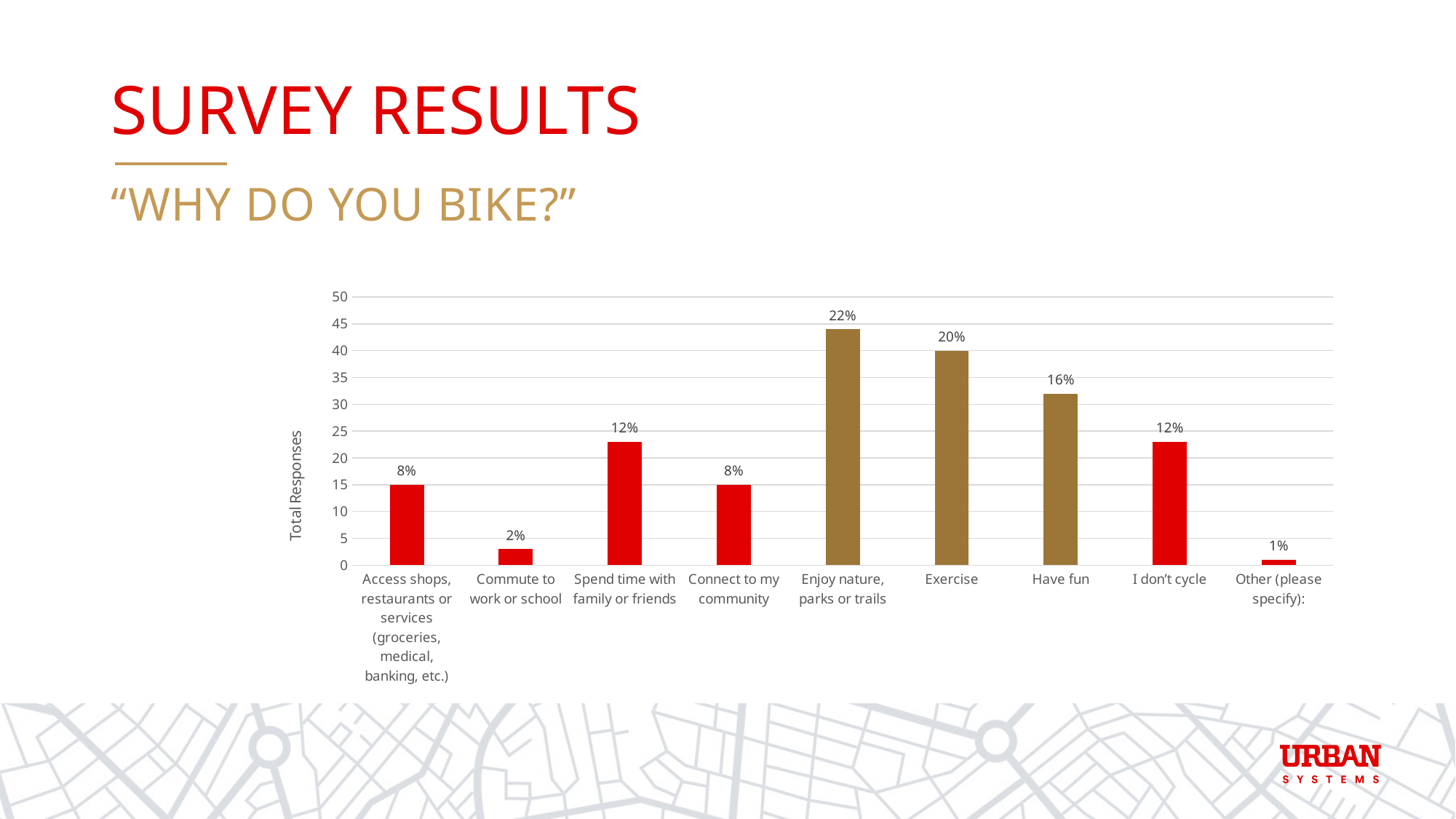
Is the number of total responses for Enjoy nature, parks or trails greater or less than 40? greater Is the number of total responses for Spend time with family or friends greater or less than 25? less What percentage is shown for Have fun? 16% Which category has the highest value? Enjoy nature, parks or trails What kind of chart is shown on the slide? Bar chart What is the label on the vertical axis? Total Responses What is the difference in percentage points between Enjoy nature, parks or trails and Exercise? 2% Which category has the lowest value? Other (please specify): How many categories are shown on the x axis? 9 What percentage is shown for Commute to work or school? 2% Which is larger, the value for Have fun or the value for I don't cycle? Have fun What percentage is shown for Enjoy nature, parks or trails? 22%